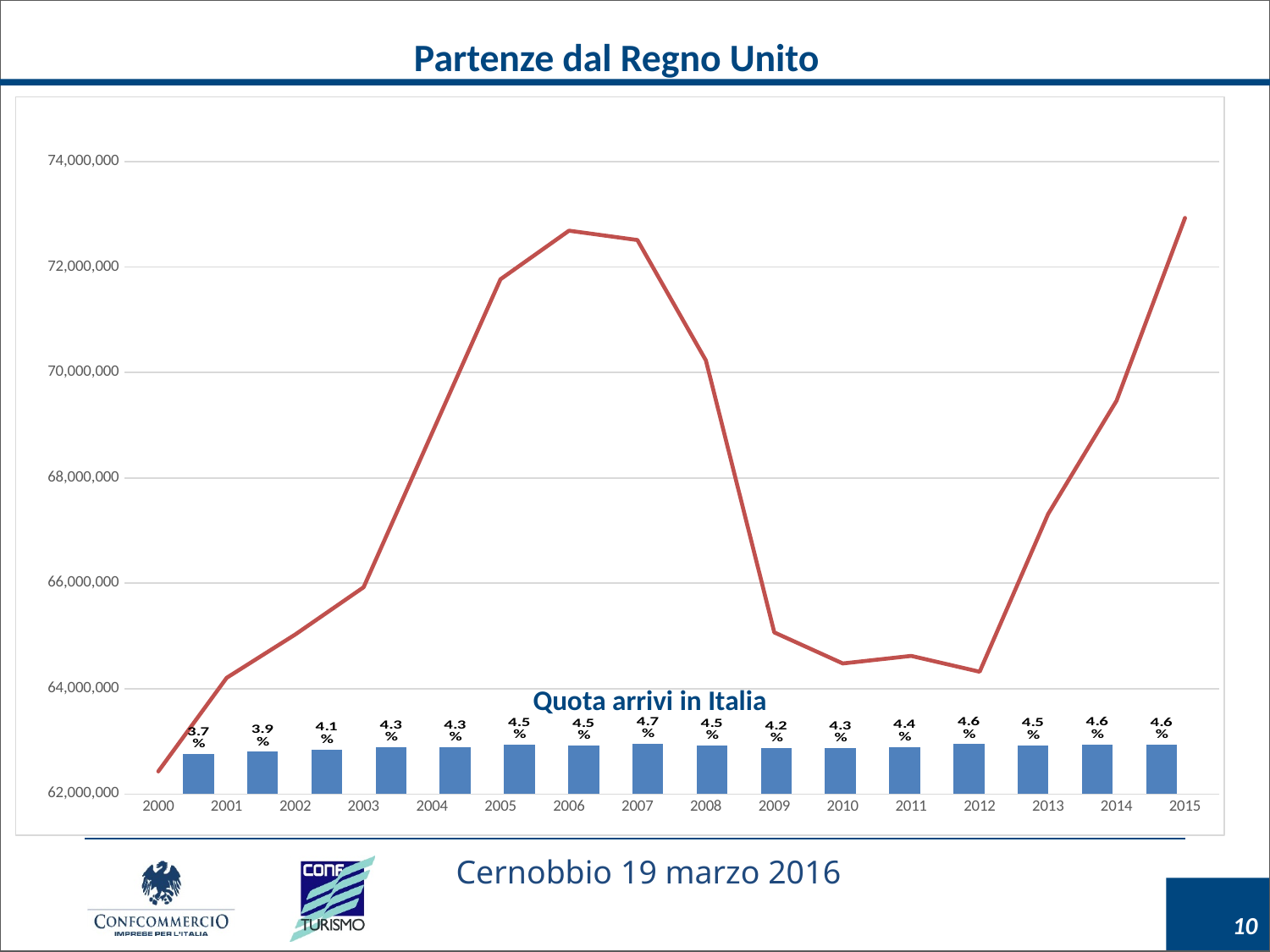
What is the 'Quota arrivi in Italia' value shown for 2000? 3.7% What is the 'Quota arrivi in Italia' value shown for 2007? 4.7% Which year has the lowest 'Quota arrivi in Italia' value? 2000 What is the title of the slide? Partenze dal Regno Unito In which year does the red line reach its lowest value? 2000 Is the value of the red line for 2009 greater or less than 66,000,000? less How many years are shown on the x axis of the chart? 16 Which is larger, the 'Quota arrivi in Italia' value for 2012 or for 2013? 2012 Which year has the highest 'Quota arrivi in Italia' value? 2007 What is the difference between the 'Quota arrivi in Italia' values for 2007 and 2000? 1.0% Is the value of the red line for 2006 greater or less than 72,000,000? greater What is the 'Quota arrivi in Italia' value shown for 2009? 4.2%